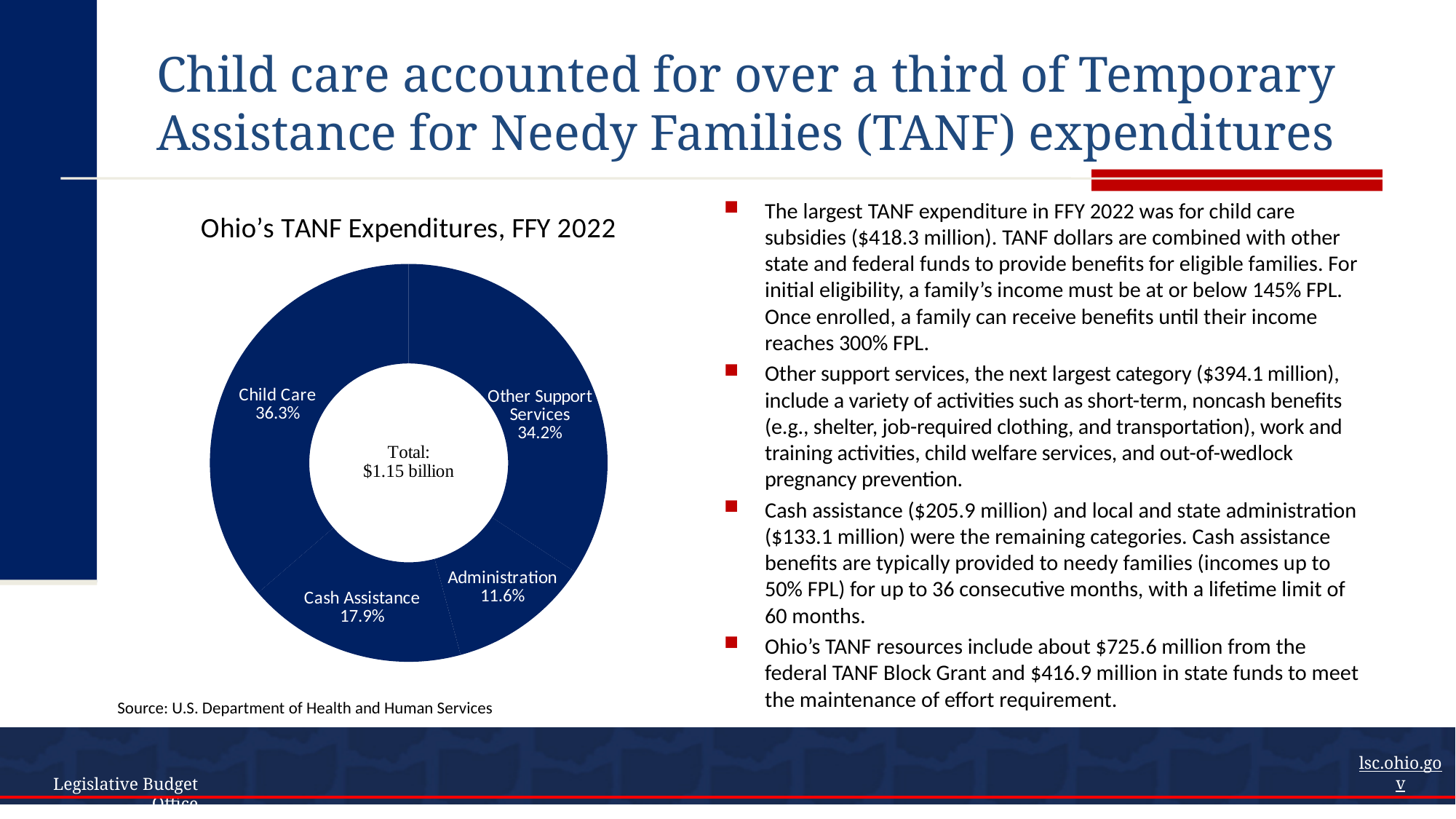
Which category has the smallest share in the chart? Administration What type of chart is used to show Ohio's TANF Expenditures, FFY 2022? Donut (pie) chart What is the difference in percentage points between the Child Care and Other Support Services shares? 2.1 What share of TANF expenditures is shown for Cash Assistance? 17.9% What percentage of the donut chart is Other Support Services? 34.2% Which is larger, the share for Cash Assistance or the share for Administration? Cash Assistance What is the difference in percentage points between Cash Assistance and Administration? 6.3 How many categories are shown in the donut chart? 4 What percentage of the chart is Administration? 11.6% What total is printed in the center of the donut chart? $1.15 billion Which category has the largest share of Ohio's TANF expenditures in the chart? Child Care What share of Ohio's TANF expenditures in FFY 2022 went to Child Care? 36.3%